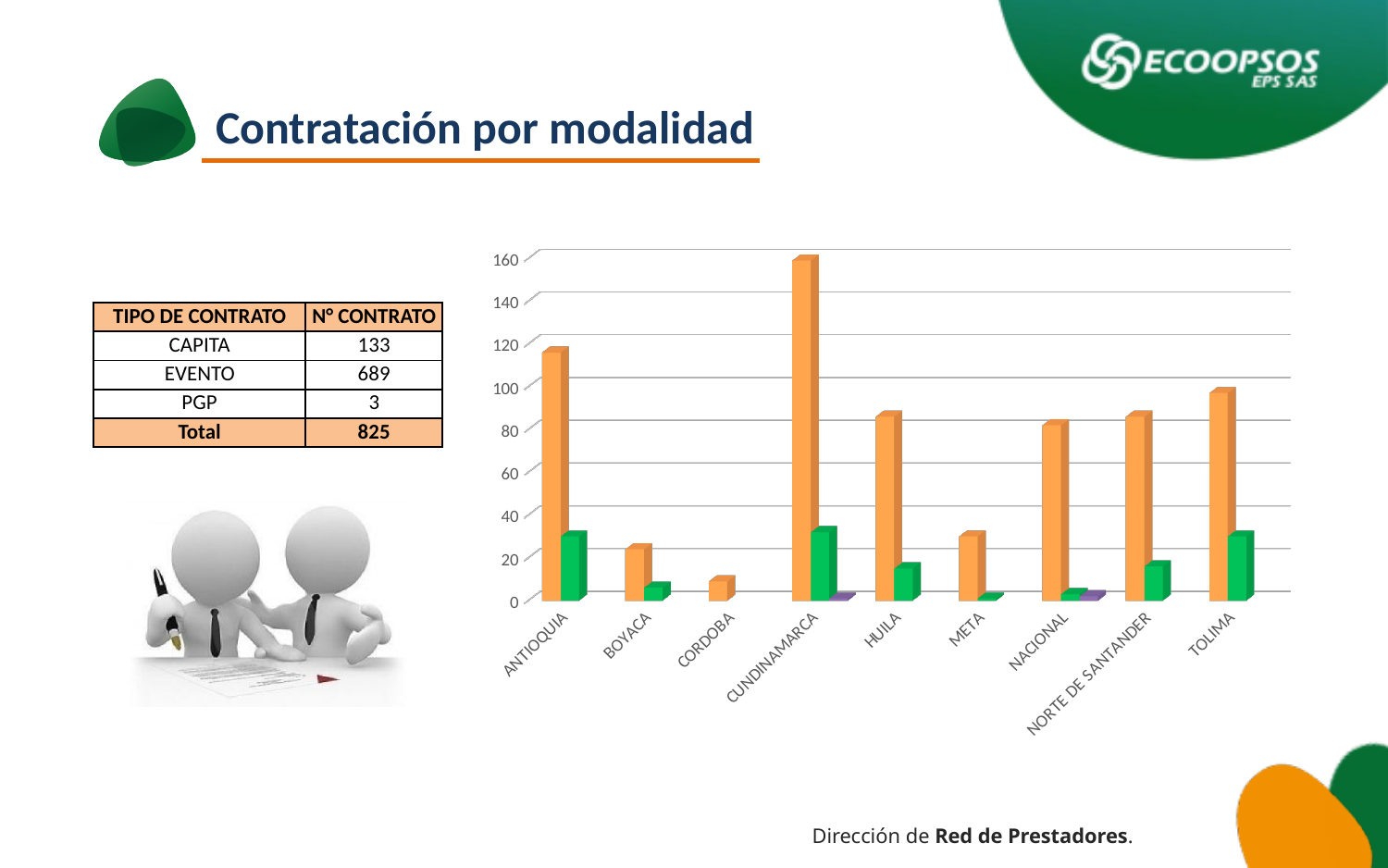
Is the orange bar for META greater or less than 40? less Which has the larger orange bar, ANTIOQUIA or TOLIMA? ANTIOQUIA What kind of chart is shown on the slide? bar chart Is the orange bar for TOLIMA greater or less than 80? greater Which has the larger green bar, CUNDINAMARCA or HUILA? CUNDINAMARCA Which category has the shortest orange bar in the chart? CORDOBA How many categories are shown on the x axis of the chart? 9 What is the title of the slide containing the chart? Contratación por modalidad Is the orange bar for CORDOBA greater or less than 20? less Which category has the tallest orange bar in the chart? CUNDINAMARCA